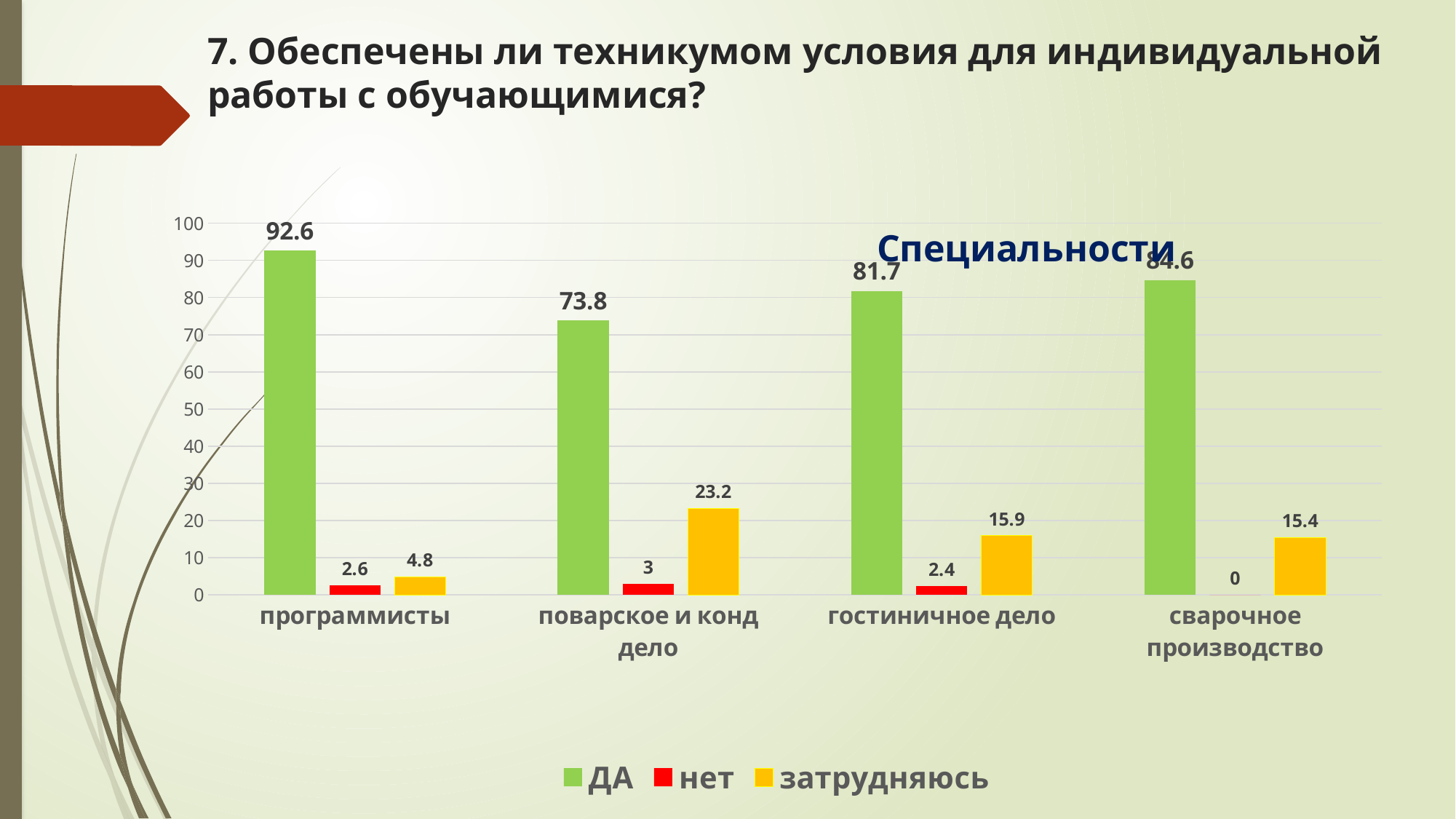
How many series does the legend list? 3 Which category has the lowest value in the ДА series? поварское и конд дело What is the value of the ДА series for программисты? 92.6 How many categories are shown on the x axis? 4 What is the value of the нет series for сварочное производство? 0 Which category has the highest value in the ДА series? программисты What is the value of the затрудняюсь series for поварское и конд дело? 23.2 What is the difference between the ДА values for программисты and поварское и конд дело? 18.8 Which is larger: the затрудняюсь value for гостиничное дело or for сварочное производство? гостиничное дело What kind of chart is shown on the slide? bar chart Is the ДА value for гостиничное дело greater or less than 80? greater Which colour represents the нет series in the legend? red